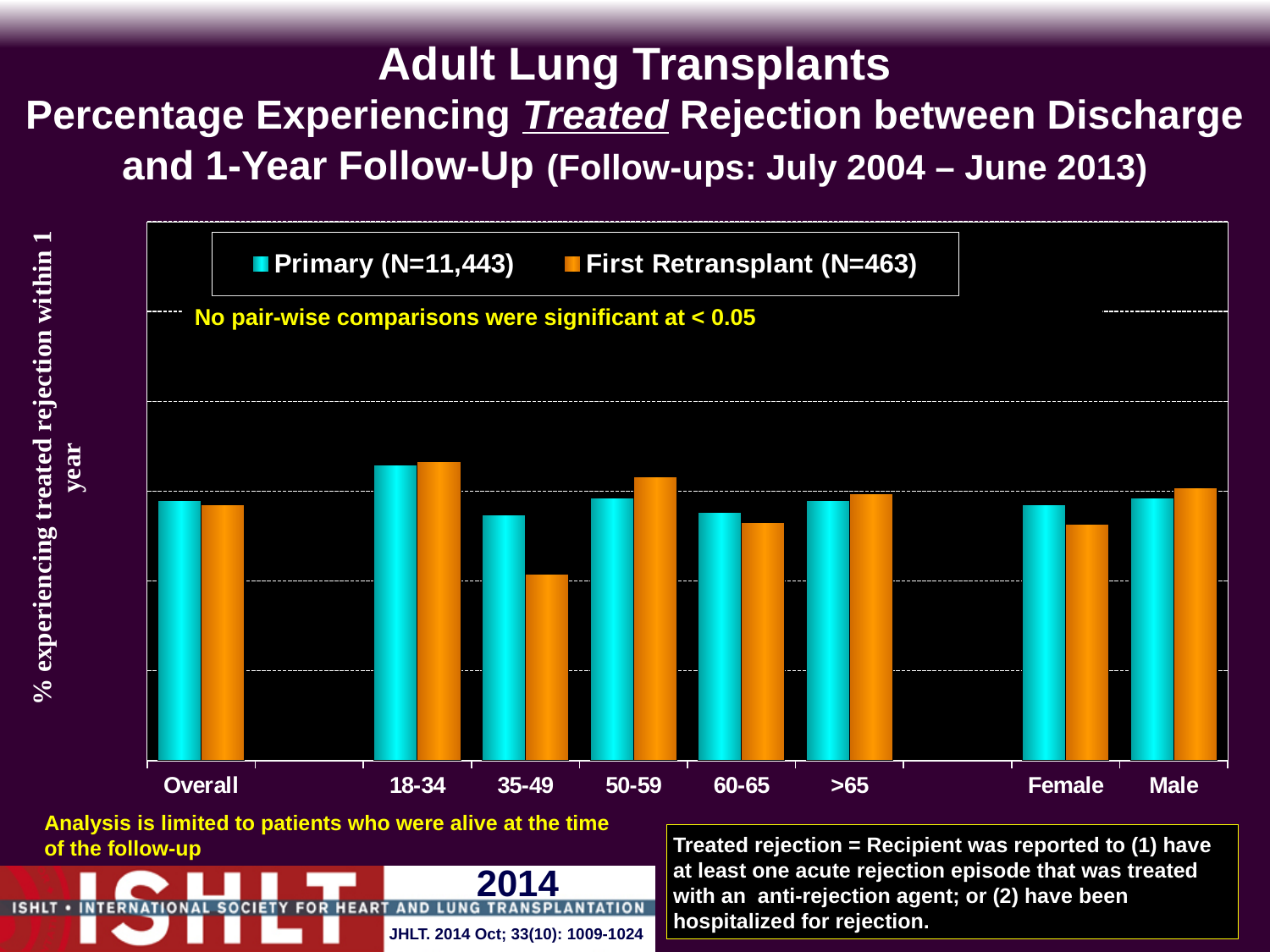
Which category has the highest value for the Primary series? 18-34 Which category has the lowest value for the Primary series? 35-49 Which category has the lowest value for the First Retransplant series? 35-49 For the 50-59 age group, which series has the larger value, Primary or First Retransplant? First Retransplant For the 35-49 age group, which series has the larger value, Primary or First Retransplant? Primary For the Female category, which series has the larger value, Primary or First Retransplant? Primary What is the N given in the legend for the Primary series? 11,443 What is the N given in the legend for the First Retransplant series? 463 What kind of chart is shown on the slide? Bar chart Which category has the highest value for the First Retransplant series? 18-34 How many series does the legend list? 2 How many categories are shown along the x axis? 8